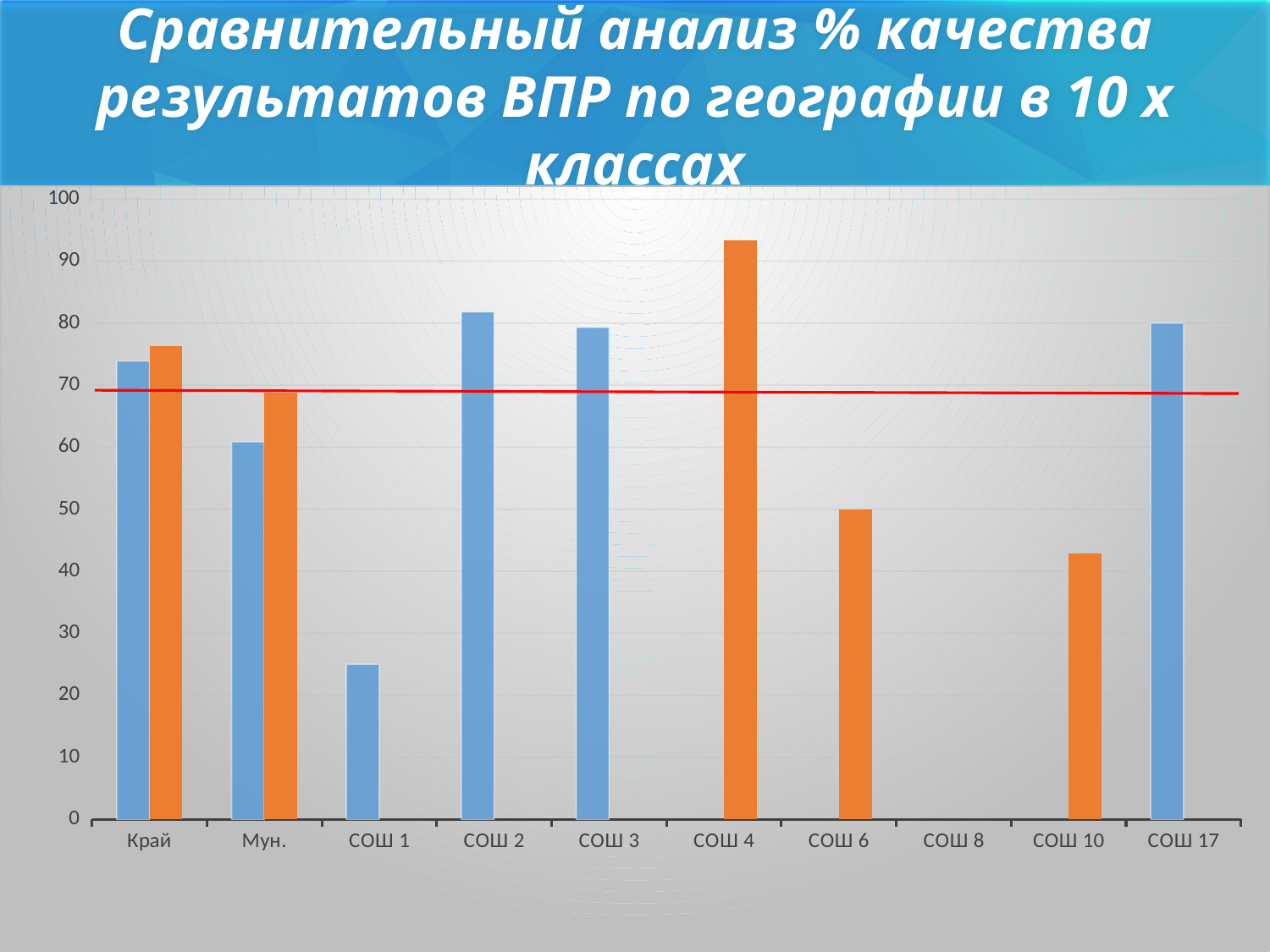
Is the value of the orange bar for СОШ 4 greater or less than 90? greater Is the value of the orange bar for СОШ 10 greater or less than 40? greater Which category has no bars plotted at all? СОШ 8 Which category has the tallest bar in the chart? СОШ 4 How many categories are shown on the x axis of the chart? 10 What kind of chart is shown on the slide? bar chart Is the value of the blue bar for СОШ 1 greater or less than 30? less Which is larger: the blue bar for СОШ 1 or the blue bar for СОШ 2? СОШ 2 Which category has the shortest non-zero bar in the chart? СОШ 1 Which is larger: the orange bar for СОШ 4 or the orange bar for СОШ 6? СОШ 4